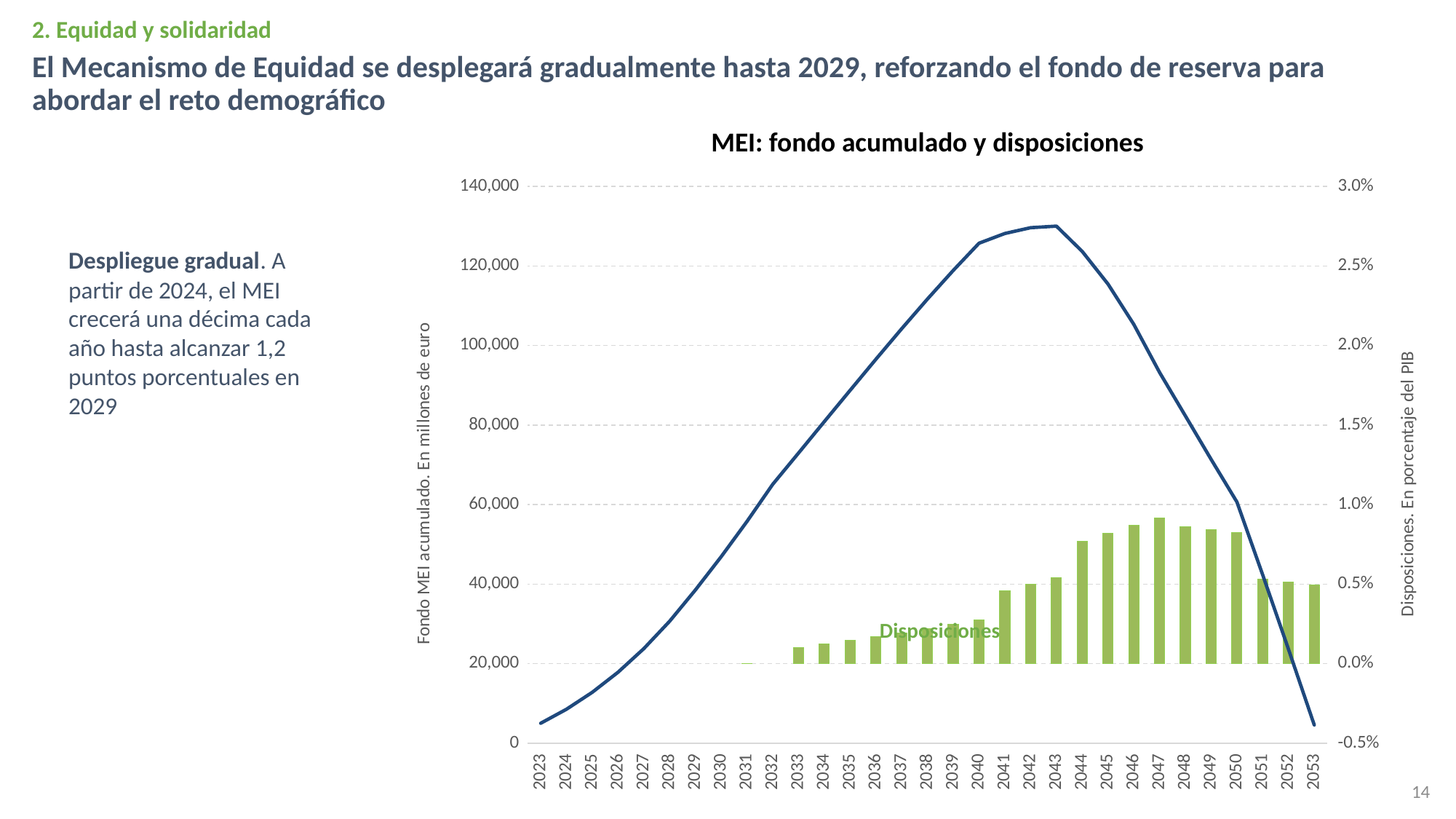
Is the accumulated fund value for 2030 greater or less than 60,000? less What is the title of the chart? MEI: fondo acumulado y disposiciones In which year is the Disposiciones bar the tallest? 2047 Does the accumulated fund line rise or fall between 2023 and 2043? rise In which year is the Disposiciones bar the shortest? 2033 What kind of chart is shown on the slide? A combined line and bar chart Is the Disposiciones value for 2047 greater or less than 0.5%? greater Is the accumulated fund value for 2043 greater or less than 120,000? greater How many years are shown on the x axis of the chart? 31 Which year has a higher accumulated fund value, 2035 or 2050? 2035 In which year does the accumulated fund line (Fondo MEI acumulado) reach its highest value? 2043 What is the label of the right-hand vertical axis? Disposiciones. En porcentaje del PIB